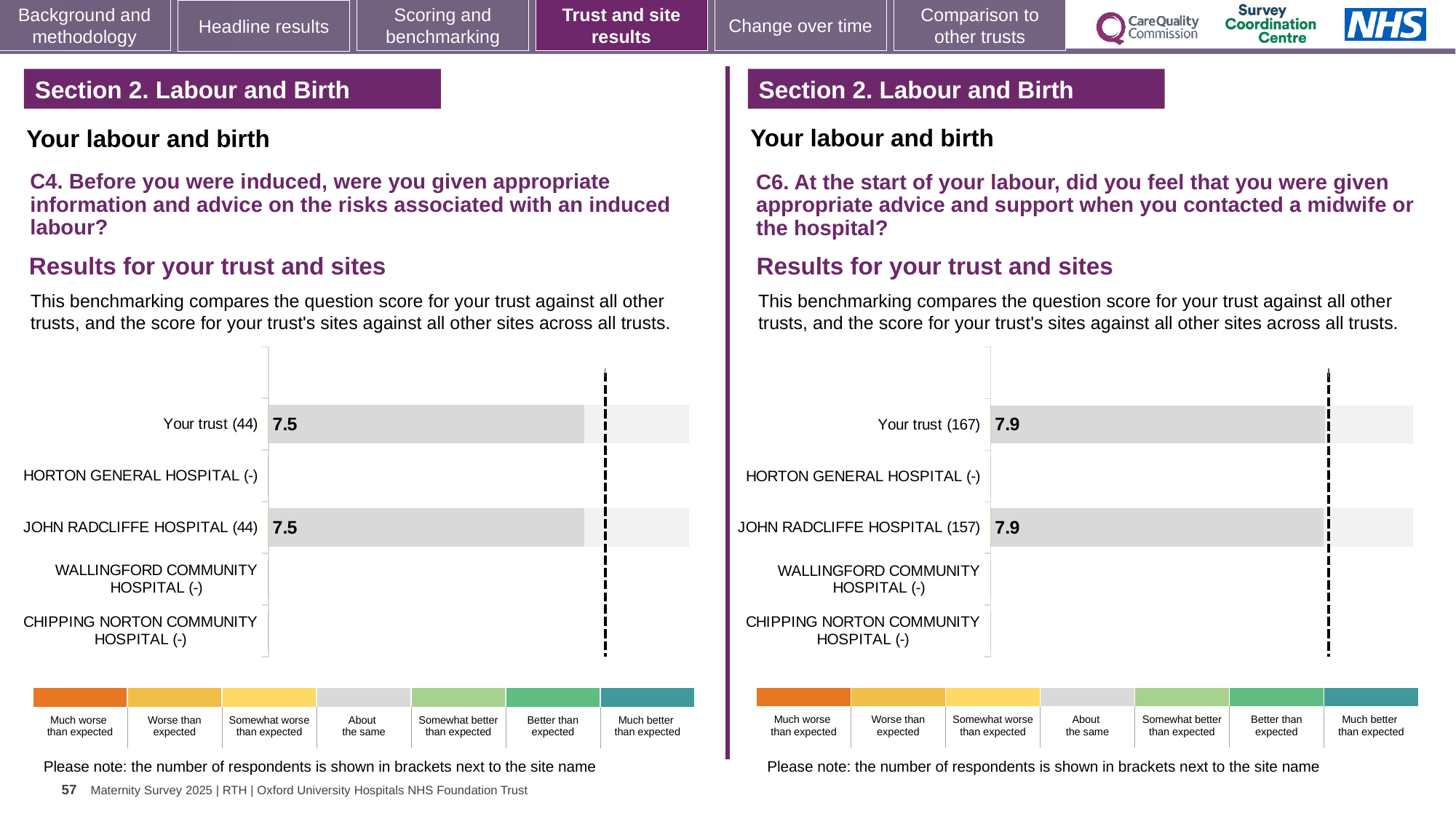
Which is larger: the Your trust score in the C4 chart on the left or the Your trust score in the C6 chart on the right? C6 chart (7.9) What type of chart is used in the C4 chart on the left? Bar chart In the C6 chart on the right, how many respondents are shown in brackets for Your trust? 167 In the C4 chart on the left, which category is labelled with the most respondents in brackets? Your trust (44) and JOHN RADCLIFFE HOSPITAL (44) In the C4 chart on the left, how many respondents are shown in brackets for Your trust? 44 In the C4 chart on the left, what is the score for JOHN RADCLIFFE HOSPITAL? 7.5 In the C6 chart on the right, how many respondents are shown in brackets for JOHN RADCLIFFE HOSPITAL? 157 In the C6 chart on the right, what is the score for Your trust? 7.9 What is the difference between the Your trust score in the C6 chart on the right and the Your trust score in the C4 chart on the left? 0.4 In the C4 chart on the left, what is the score for Your trust? 7.5 In the C6 chart on the right, what is the score for JOHN RADCLIFFE HOSPITAL? 7.9 How many site/trust categories are listed on the y axis of the C4 chart on the left? 5